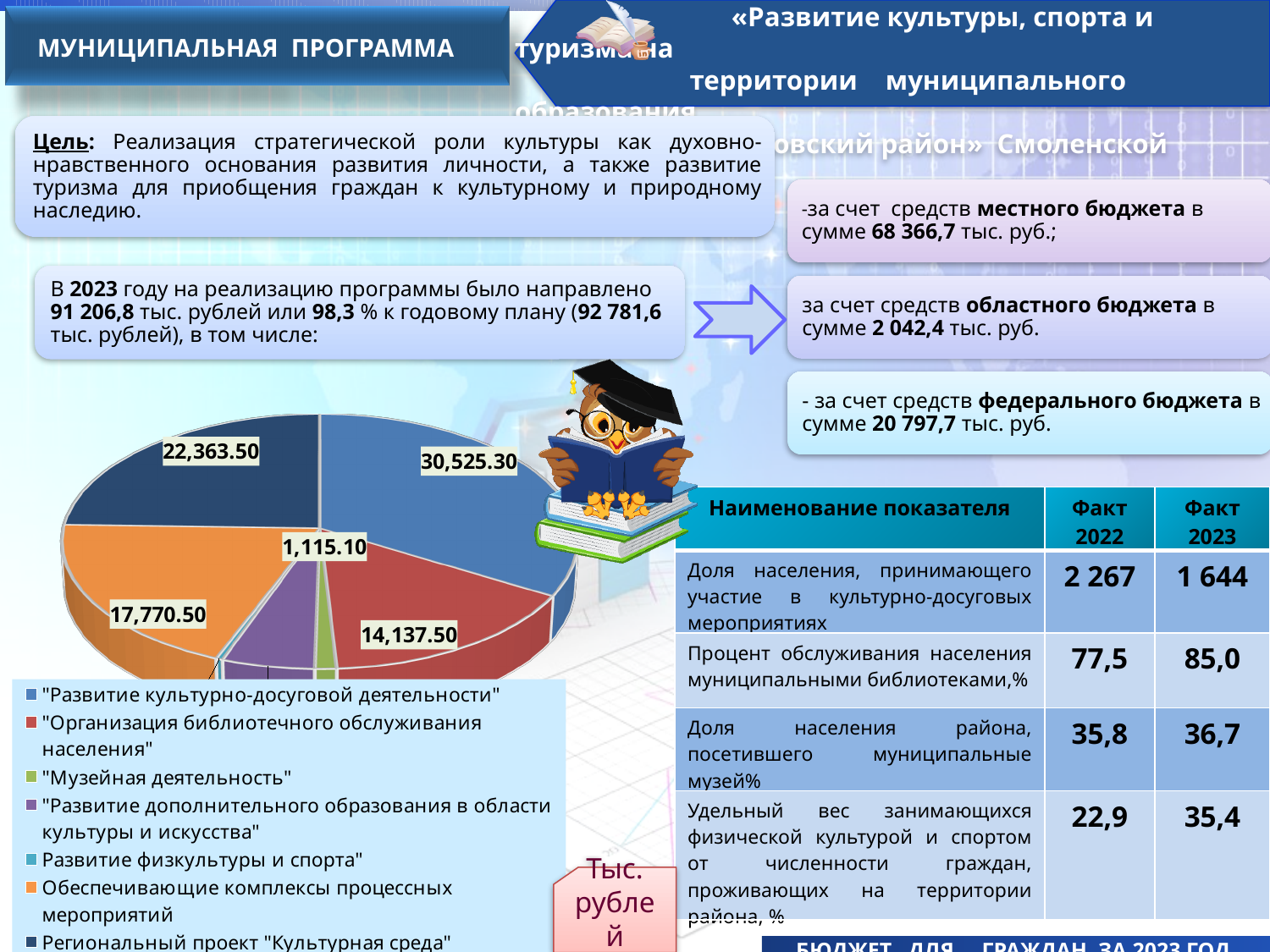
What is the value for "Региональный проект "Культурная среда"" in the pie chart? 22,363.50 What is the value for "Развитие культурно-досуговой деятельности" in the pie chart? 30,525.30 Which category has the largest slice in the pie chart? "Развитие культурно-досуговой деятельности" What is the difference between the values for "Развитие культурно-досуговой деятельности" and "Региональный проект "Культурная среда""? 8,161.80 What is the difference between the values for "Региональный проект "Культурная среда"" and "Обеспечивающие комплексы процессных мероприятий"? 4,593.00 Which is larger: the value for "Развитие культурно-досуговой деятельности" or for "Региональный проект "Культурная среда""? "Развитие культурно-досуговой деятельности" In what units are the values of the pie chart given, according to the label next to the legend? Тыс. рублей Which is larger: the value for "Организация библиотечного обслуживания населения" or for "Обеспечивающие комплексы процессных мероприятий"? "Обеспечивающие комплексы процессных мероприятий" How many categories does the legend of the pie chart list? 7 What is the value for "Организация библиотечного обслуживания населения" in the pie chart? 14,137.50 What kind of chart is shown on the slide? pie chart What is the value for "Обеспечивающие комплексы процессных мероприятий" in the pie chart? 17,770.50